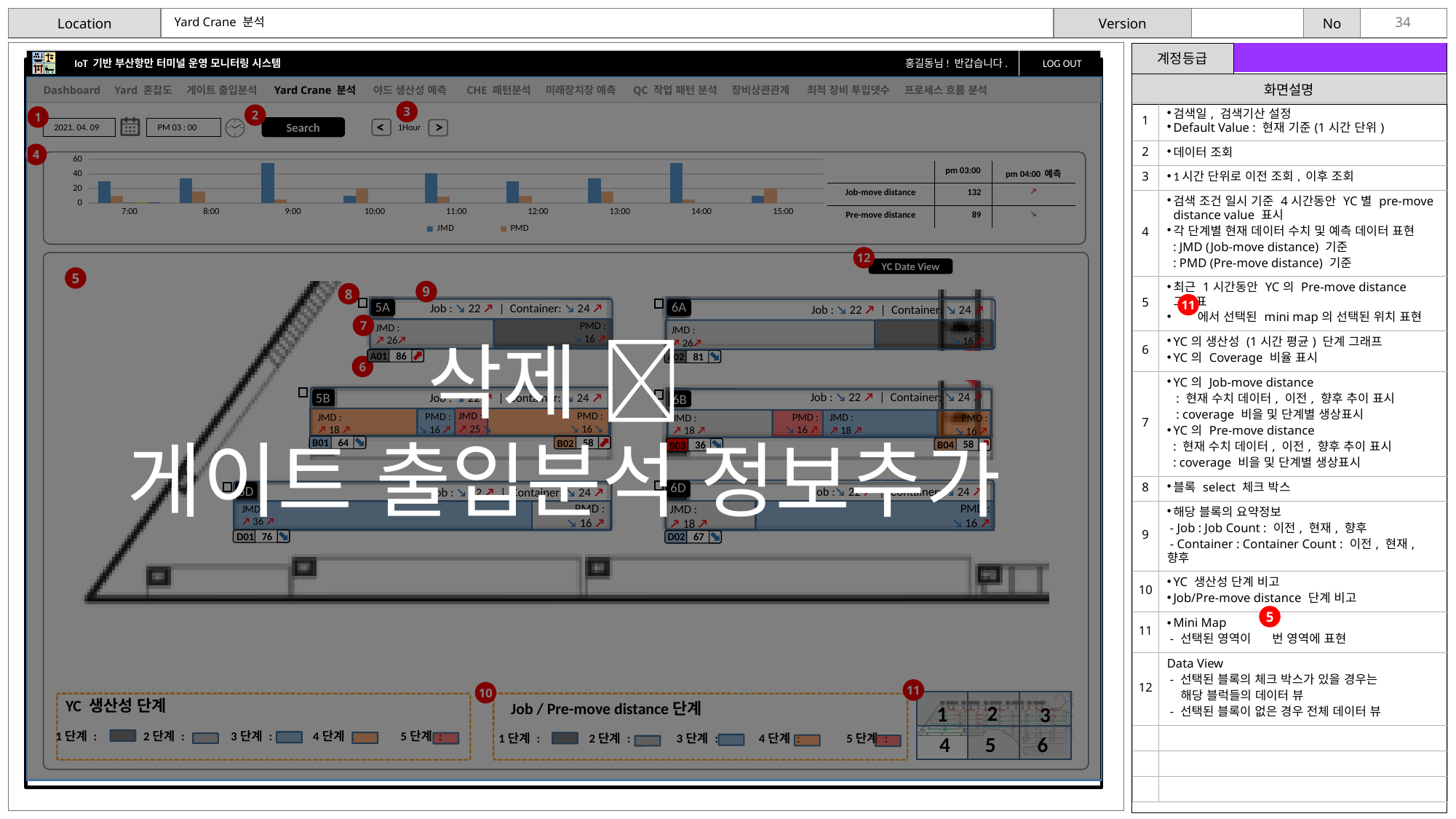
In the top bar chart, is the JMD value at 9:00 greater or less than 40? greater How many series does the legend of the top bar chart list? 2 In the top bar chart, is the JMD value at 11:00 greater or less than 20? greater How many time points are shown along the x axis of the top bar chart? 9 What kind of chart is shown in the top panel of the monitoring screen? bar chart What are the two series named in the legend of the top bar chart? JMD and PMD In the top bar chart, is the PMD value at 7:00 greater or less than 20? less What is the first time label on the x axis of the top bar chart? 7:00 In the top bar chart, which series has the larger value at 10:00, JMD or PMD? PMD In the top bar chart, which series has the larger value at 7:00, JMD or PMD? JMD